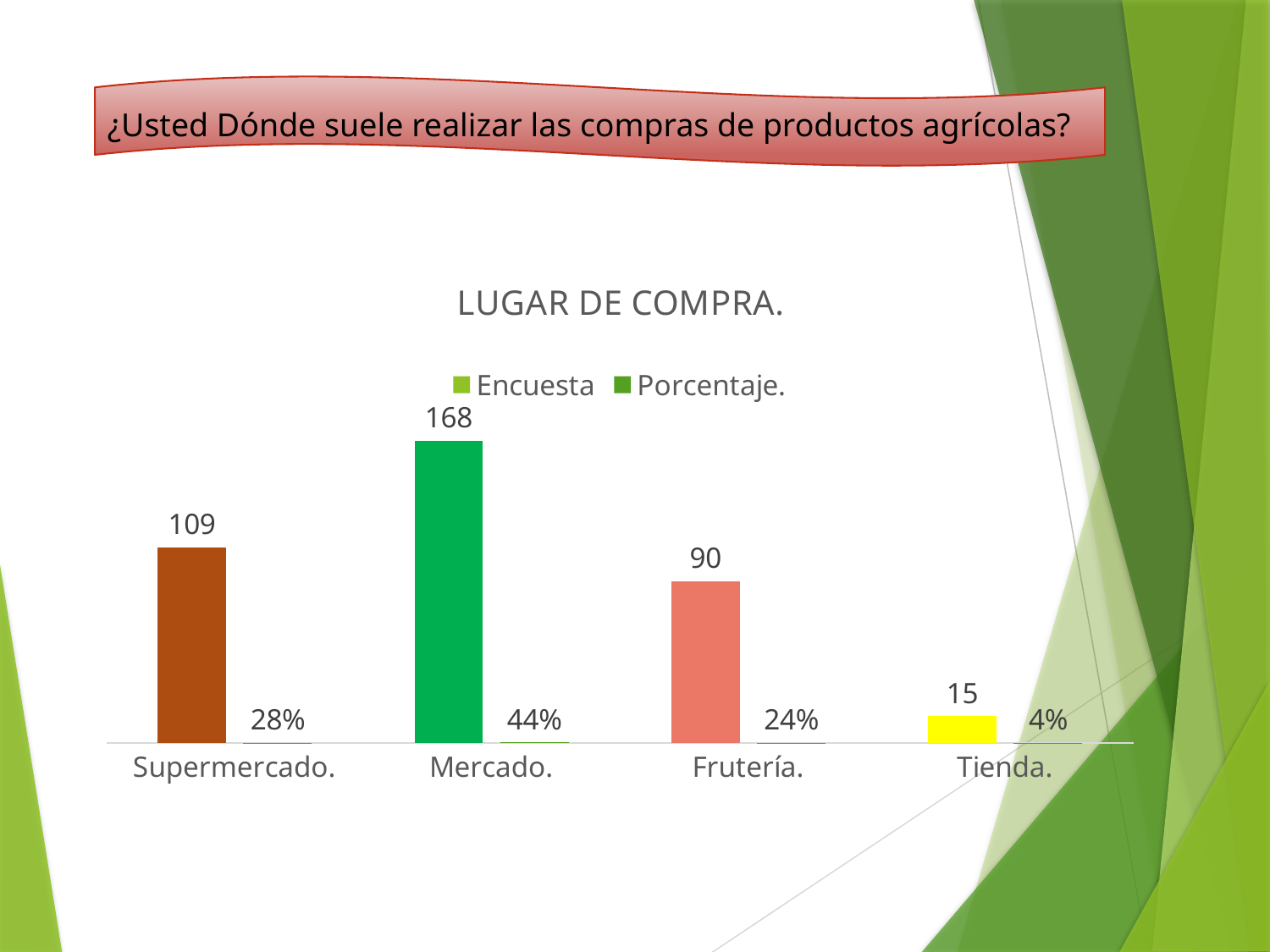
What is the difference between the Encuesta values for Mercado and Supermercado? 59 How many series does the legend list? 2 What is the title of the chart? LUGAR DE COMPRA. What is the Porcentaje value for Tienda? 4% Which category has the highest Encuesta value? Mercado Which category has the lowest Encuesta value? Tienda What is the difference between the Encuesta values for Frutería and Tienda? 75 Which has a larger Encuesta value, Supermercado or Frutería? Supermercado What is the Porcentaje value for Frutería? 24% How many categories are shown on the x axis? 4 What is the Encuesta value for Mercado? 168 What is the Encuesta value for Supermercado? 109